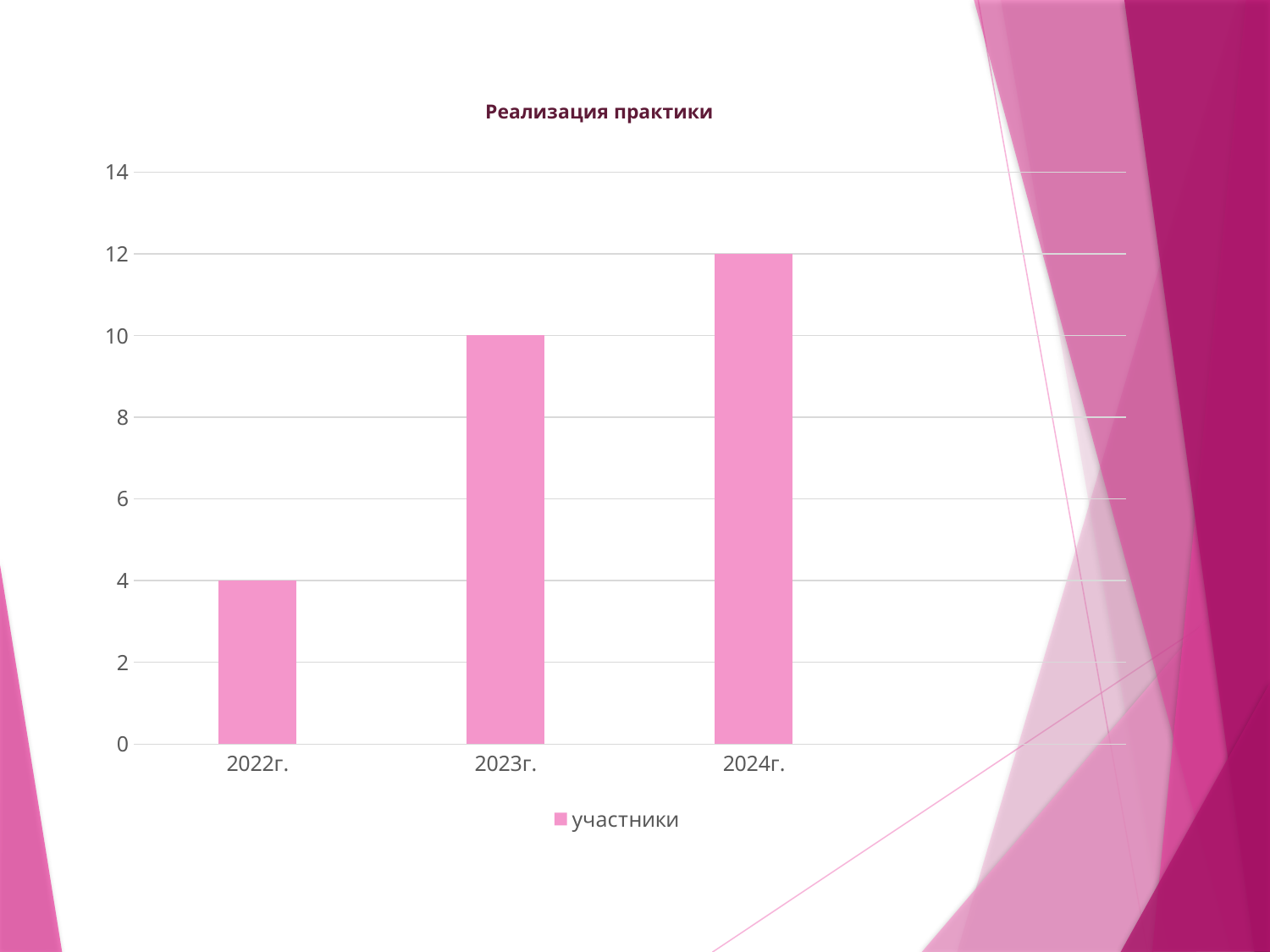
Which is larger, the value for 2023г. or the value for 2024г.? 2024г. What is the difference between the values for 2024г. and 2022г.? 8 Which year has the lowest value? 2022г. What kind of chart is shown? bar chart Is the value for 2023г. greater or less than 8? greater What is the value for 2024г.? 12 What is the value for 2022г.? 4 Which year has the highest value? 2024г. How many series does the legend list? 1 What is the difference between the values for 2023г. and 2022г.? 6 What is the value for 2023г.? 10 How many categories are shown on the x axis? 3